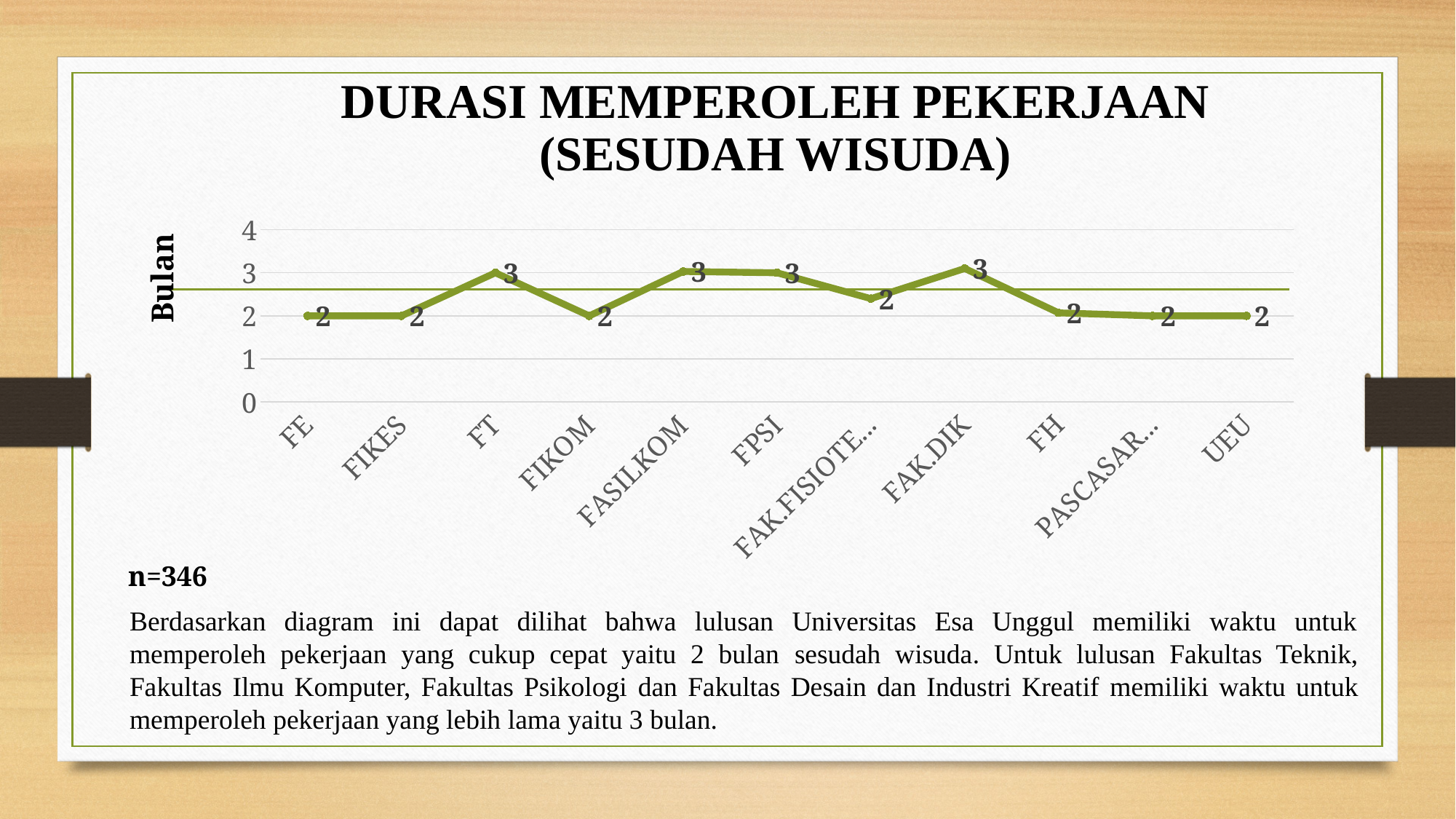
What is the value for FAK.DIK? 3 What is the value for FH? 2 How many categories are plotted along the x axis? 11 What is the difference between the values for FT and FIKOM? 1 What is the value for UEU? 2 What is the value for FT? 3 Which has the larger value, FPSI or FIKES? FPSI Does the line rise or fall from FIKES to FT? rise What kind of chart is shown on the slide? line chart What is the label on the vertical axis? Bulan What is the value for FE? 2 What is the value for FASILKOM? 3